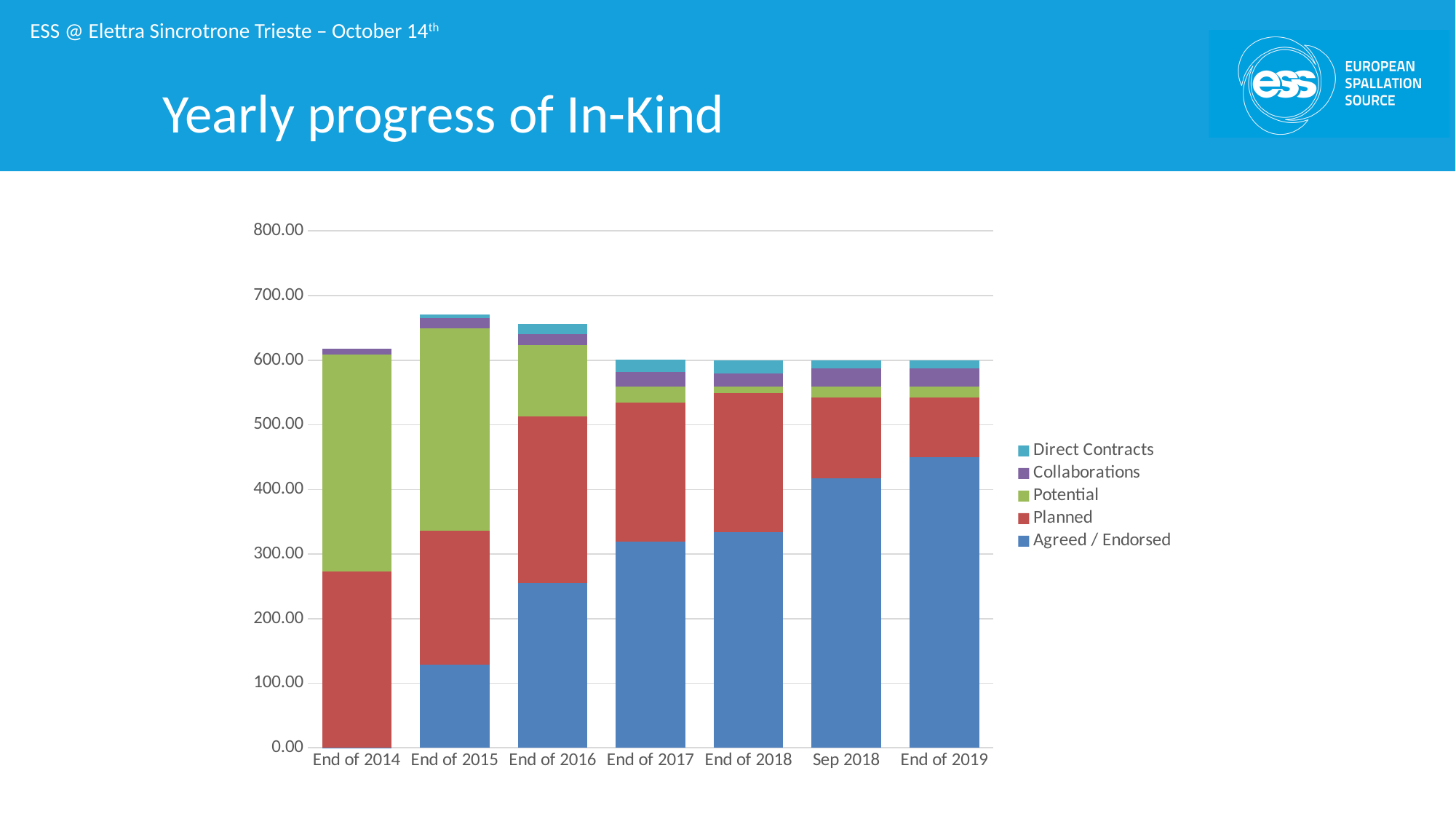
Does the Agreed / Endorsed series rise or fall from End of 2015 to End of 2019? Rise What kind of chart is shown on the slide? Stacked bar chart What is the title of the chart on the slide? Yearly progress of In-Kind Which category has the tallest stacked bar overall? End of 2015 How many series does the chart's legend list? 5 Is the Agreed / Endorsed value for End of 2019 greater or less than 400? greater Is the total of the End of 2014 stacked bar greater or less than 700? less Which series is shown in red in the chart? Planned How many categories are shown along the x axis of the chart? 7 Is the Agreed / Endorsed value for End of 2015 greater or less than 200? less Which is larger, the Potential value for End of 2014 or for End of 2017? End of 2014 Which is larger, the Agreed / Endorsed value for End of 2016 or for End of 2019? End of 2019